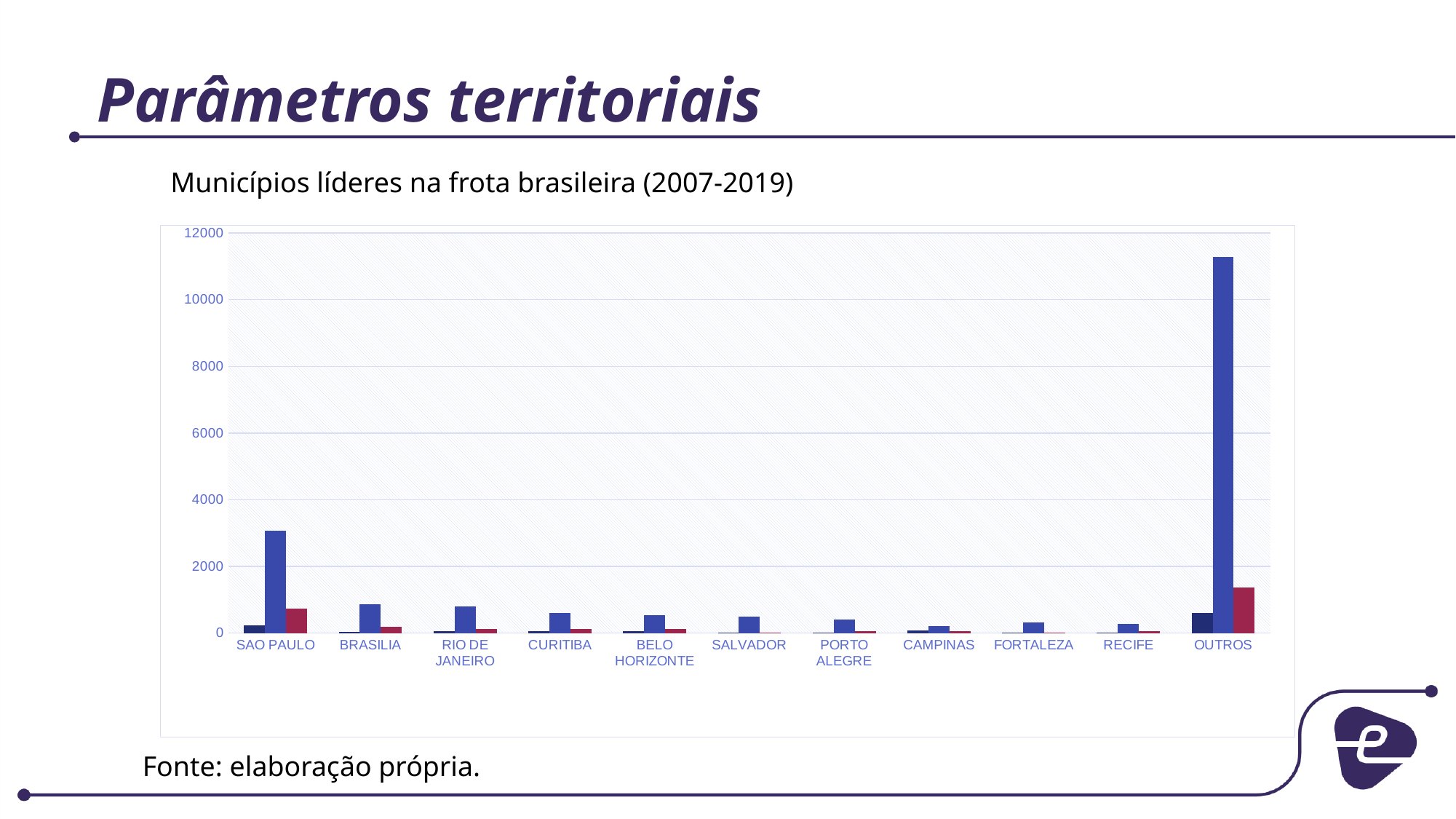
Is the tallest bar for SAO PAULO greater or less than 4000? less Excluding OUTROS, which city has the tallest bar in the chart? SAO PAULO What is the title of the chart? Municípios líderes na frota brasileira (2007-2019) Is the tallest bar for OUTROS greater or less than 10000? greater What kind of chart is shown on the slide? bar chart Which category has the tallest bar in the chart? OUTROS Is the tallest bar for BRASILIA greater or less than 2000? less What is the highest value shown on the chart's y axis? 12000 Which has a taller blue bar, SAO PAULO or BRASILIA? SAO PAULO Which has a taller blue bar, RIO DE JANEIRO or CAMPINAS? RIO DE JANEIRO How many categories are shown along the x axis of the chart? 11